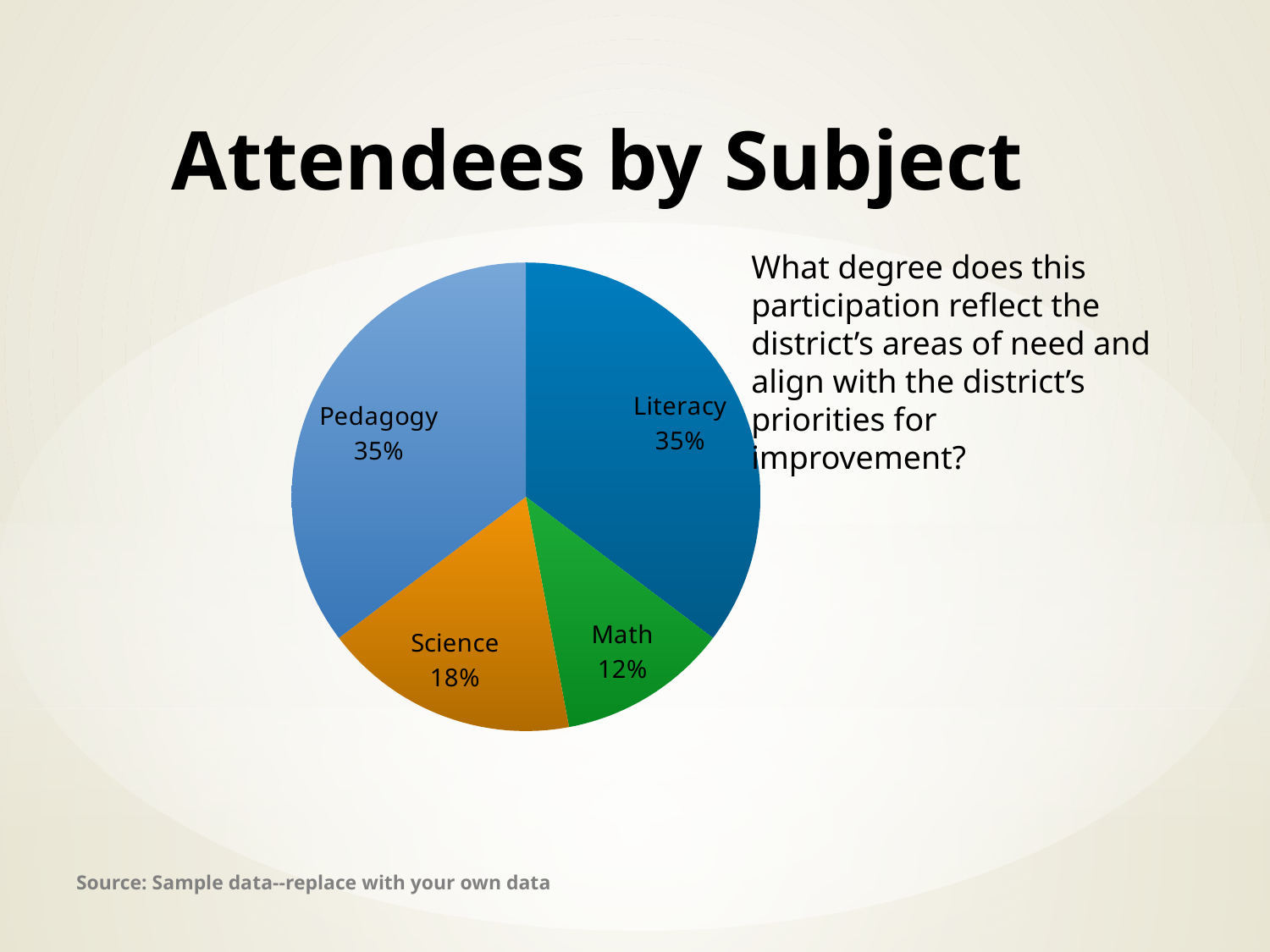
What share of attendees is for Math? 12% What share of attendees is for Pedagogy? 35% Which has a larger share of attendees, Pedagogy or Science? Pedagogy How many subjects are shown in the pie chart? 4 What is the title of the slide's chart? Attendees by Subject Which subject has the smallest share of attendees? Math What colour is the Science slice of the pie chart? Orange What is the difference in percentage points between the Science and Math shares? 6 What kind of chart is shown on the slide? Pie chart What share of attendees is for Literacy? 35% What share of attendees is for Science? 18% Which has a larger share of attendees, Science or Math? Science